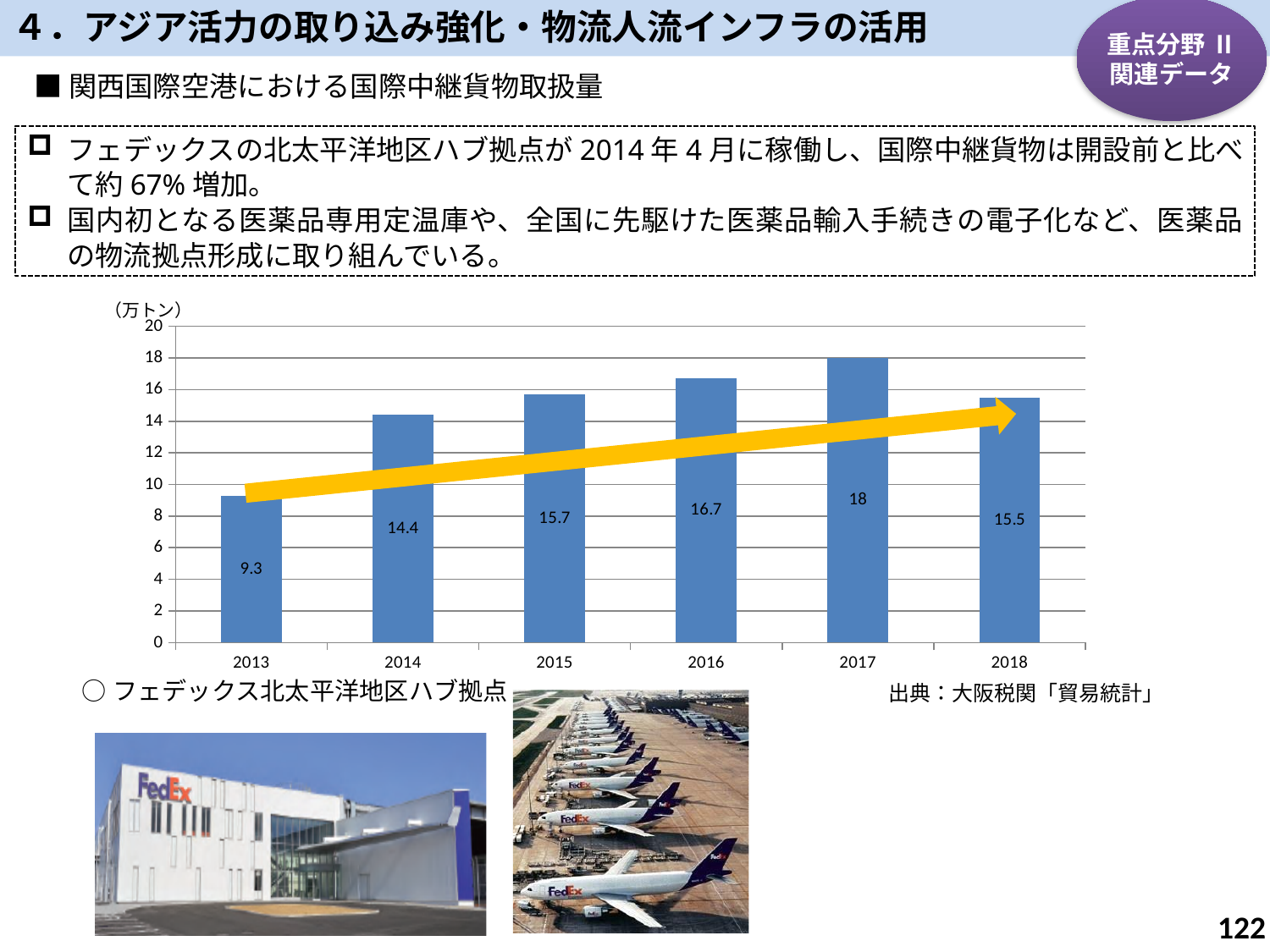
Which year has the highest value? 2017 Which is larger, the value for 2016 or the value for 2018? 2016 What is the difference between the values for 2015 and 2014? 1.3 What unit is shown on the vertical axis of the chart? 万トン Which year has the lowest value? 2013 What is the value for 2018? 15.5 What is the difference between the values for 2017 and 2013? 8.7 What kind of chart is shown on the slide? bar chart What is the value for 2013? 9.3 Is the value for 2014 greater or less than 12? greater How many years are shown on the x axis? 6 What is the value for 2016? 16.7